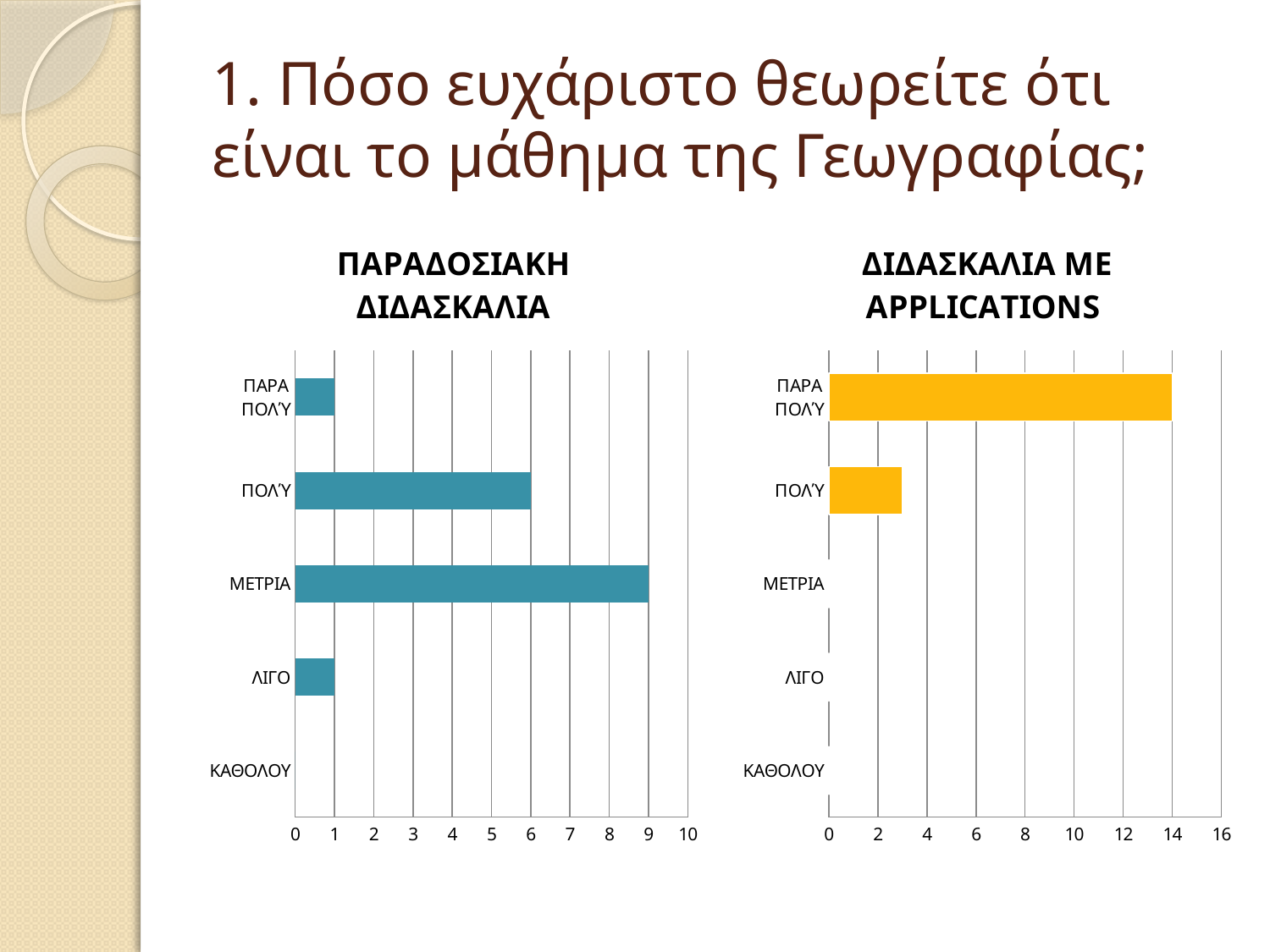
In the ΠΑΡΑΔΟΣΙΑΚΗ ΔΙΔΑΣΚΑΛΙΑ chart, what is the value for ΜΕΤΡΙΑ? 9 How many categories are shown on the y axis of the ΠΑΡΑΔΟΣΙΑΚΗ ΔΙΔΑΣΚΑΛΙΑ chart? 5 In the ΔΙΔΑΣΚΑΛΙΑ ΜΕ APPLICATIONS chart, what is the value for ΠΑΡΑ ΠΟΛΎ? 14 In the ΔΙΔΑΣΚΑΛΙΑ ΜΕ APPLICATIONS chart, which is larger, ΠΑΡΑ ΠΟΛΎ or ΠΟΛΎ? ΠΑΡΑ ΠΟΛΎ What is the title of the chart on the left of the slide? ΠΑΡΑΔΟΣΙΑΚΗ ΔΙΔΑΣΚΑΛΙΑ In the ΔΙΔΑΣΚΑΛΙΑ ΜΕ APPLICATIONS chart, is the value for ΠΟΛΎ greater or less than 4? less In the ΔΙΔΑΣΚΑΛΙΑ ΜΕ APPLICATIONS chart, which category has the highest value? ΠΑΡΑ ΠΟΛΎ In the ΠΑΡΑΔΟΣΙΑΚΗ ΔΙΔΑΣΚΑΛΙΑ chart, which category has the highest value? ΜΕΤΡΙΑ What kind of chart is the ΔΙΔΑΣΚΑΛΙΑ ΜΕ APPLICATIONS chart? Bar chart In the ΠΑΡΑΔΟΣΙΑΚΗ ΔΙΔΑΣΚΑΛΙΑ chart, what is the value for ΛΙΓΟ? 1 In the ΠΑΡΑΔΟΣΙΑΚΗ ΔΙΔΑΣΚΑΛΙΑ chart, what is the value for ΠΟΛΎ? 6 In the ΠΑΡΑΔΟΣΙΑΚΗ ΔΙΔΑΣΚΑΛΙΑ chart, what is the difference between ΜΕΤΡΙΑ and ΠΟΛΎ? 3